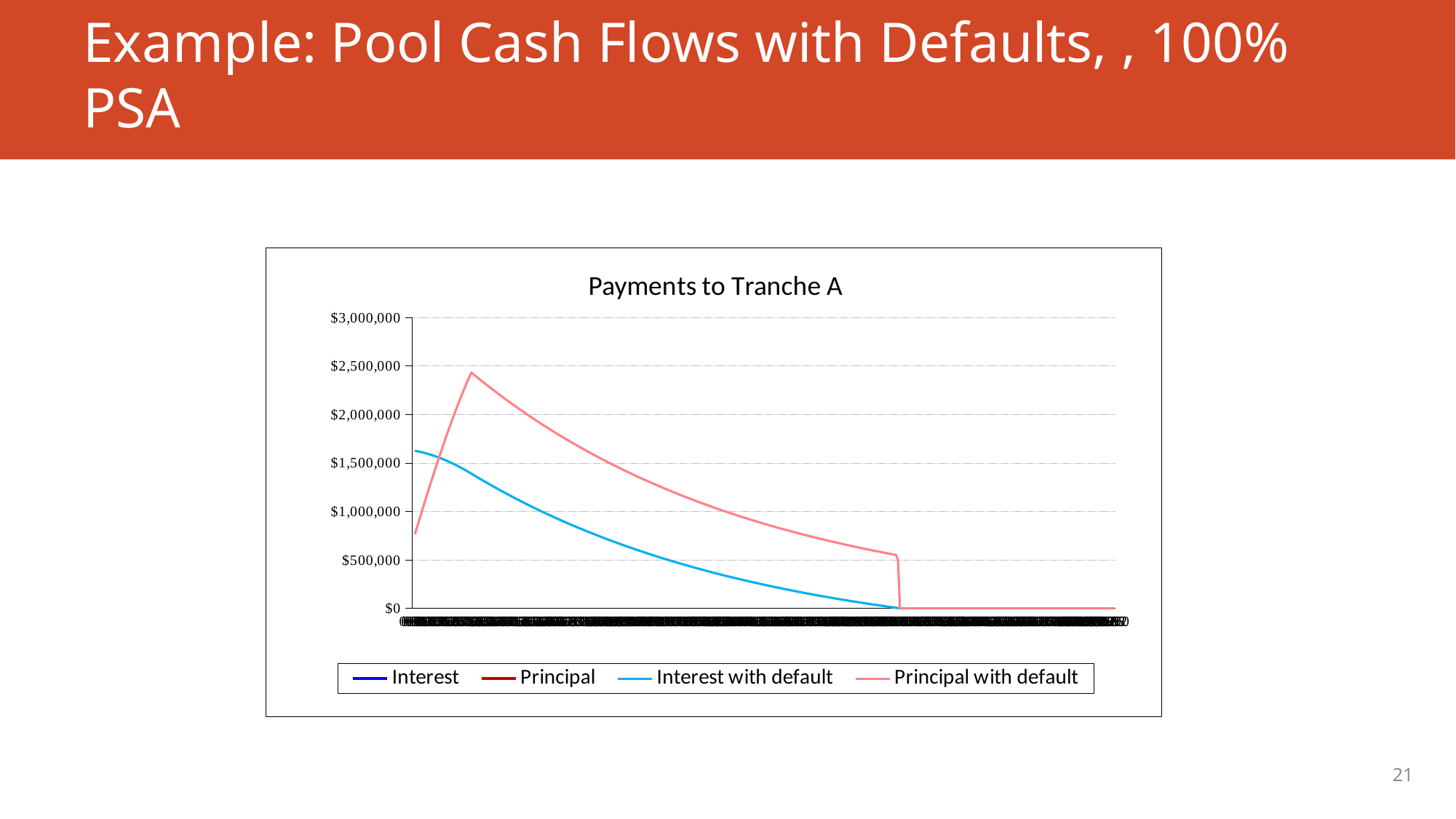
What is the highest value shown on the y axis? $3,000,000 What kind of chart is shown on the slide? line chart Is the starting value of the Interest with default series greater or less than $1,500,000? greater Is the starting value of the Principal with default series greater or less than $1,000,000? less Is the value of the Principal with default series just before it drops to zero greater or less than $1,000,000? less Which series reaches a higher peak value, Interest with default or Principal with default? Principal with default How many series does the chart's legend list? 4 Does the Interest with default series rise or fall along the x axis after its starting point? fall What is the title of the chart? Payments to Tranche A